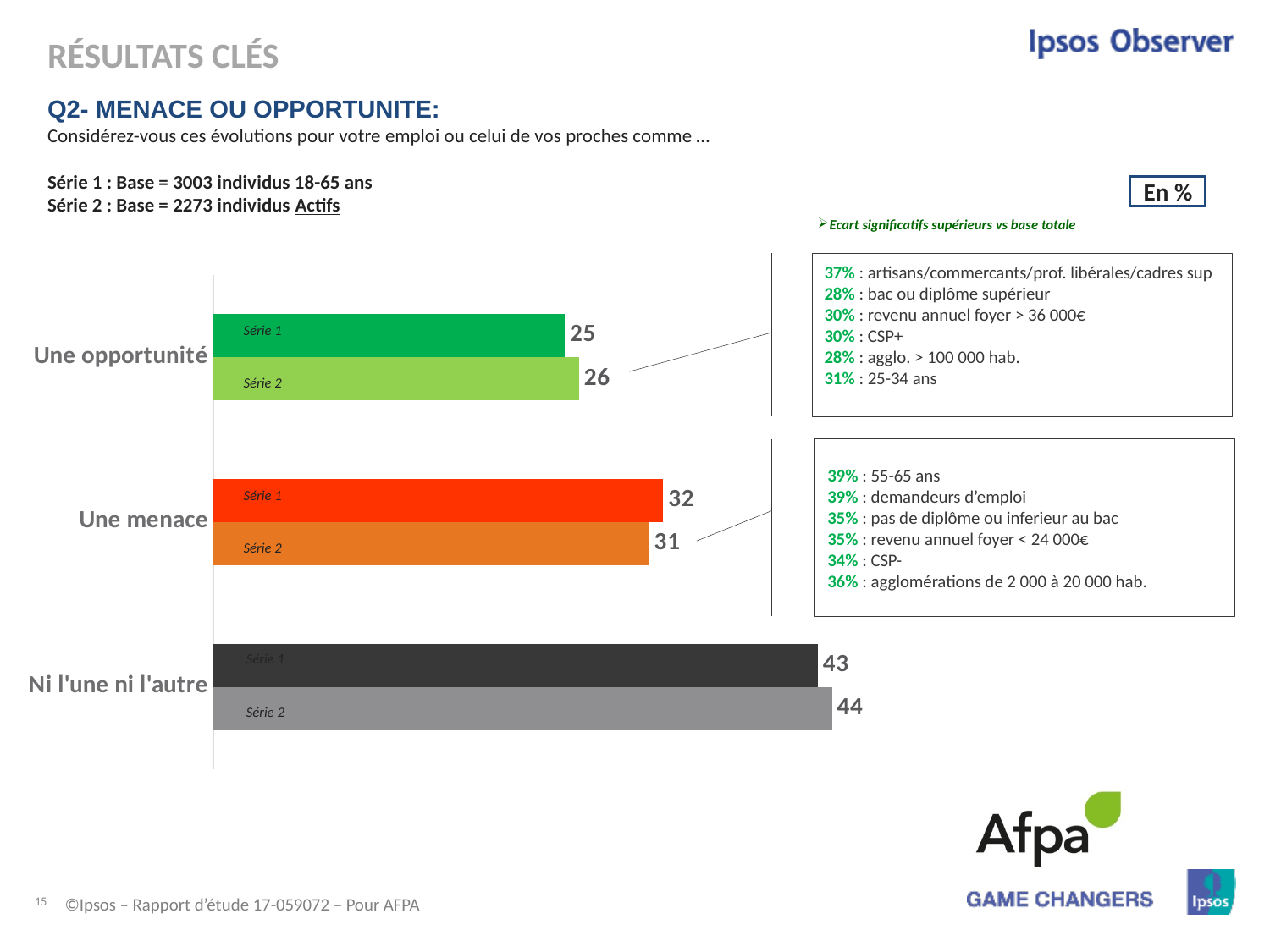
What is the Série 1 value for "Ni l'une ni l'autre"? 43 What is the difference between the Série 1 values for "Une menace" and "Une opportunité"? 7 How many categories are shown in the chart? 3 Which is larger for "Une menace": the Série 1 value or the Série 2 value? Série 1 What is the base of Série 2 according to the slide? 2273 individus Actifs Which category has the lowest Série 2 value? Une opportunité What kind of chart is shown on the slide? Bar chart What is the Série 2 value for "Ni l'une ni l'autre"? 44 How many series does the chart show? 2 Which category has the highest Série 1 value? Ni l'une ni l'autre What is the Série 2 value for "Une menace"? 31 What is the Série 1 value for "Une opportunité"? 25